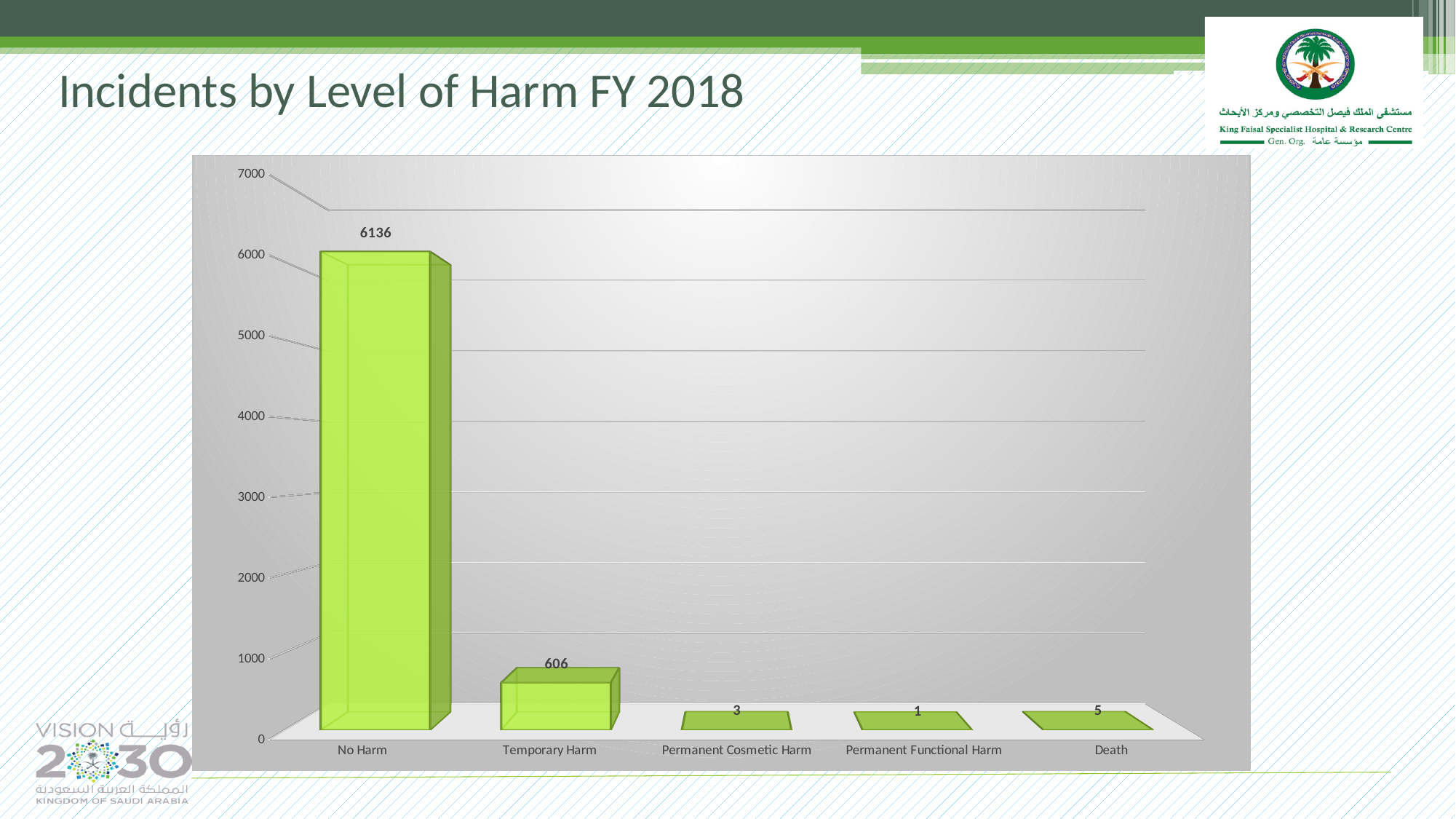
Is the value for Temporary Harm greater or less than 1000? less Which category has the highest value? No Harm What is the difference between the values for No Harm and Temporary Harm? 5530 How many categories are shown on the x axis? 5 What is the value for Temporary Harm? 606 What kind of chart is shown on the slide? bar chart What is the value for Permanent Functional Harm? 1 What is the value for No Harm? 6136 What is the value for Death? 5 Which is larger, the value for Death or the value for Permanent Cosmetic Harm? Death Which category has the lowest value? Permanent Functional Harm What is the value for Permanent Cosmetic Harm? 3